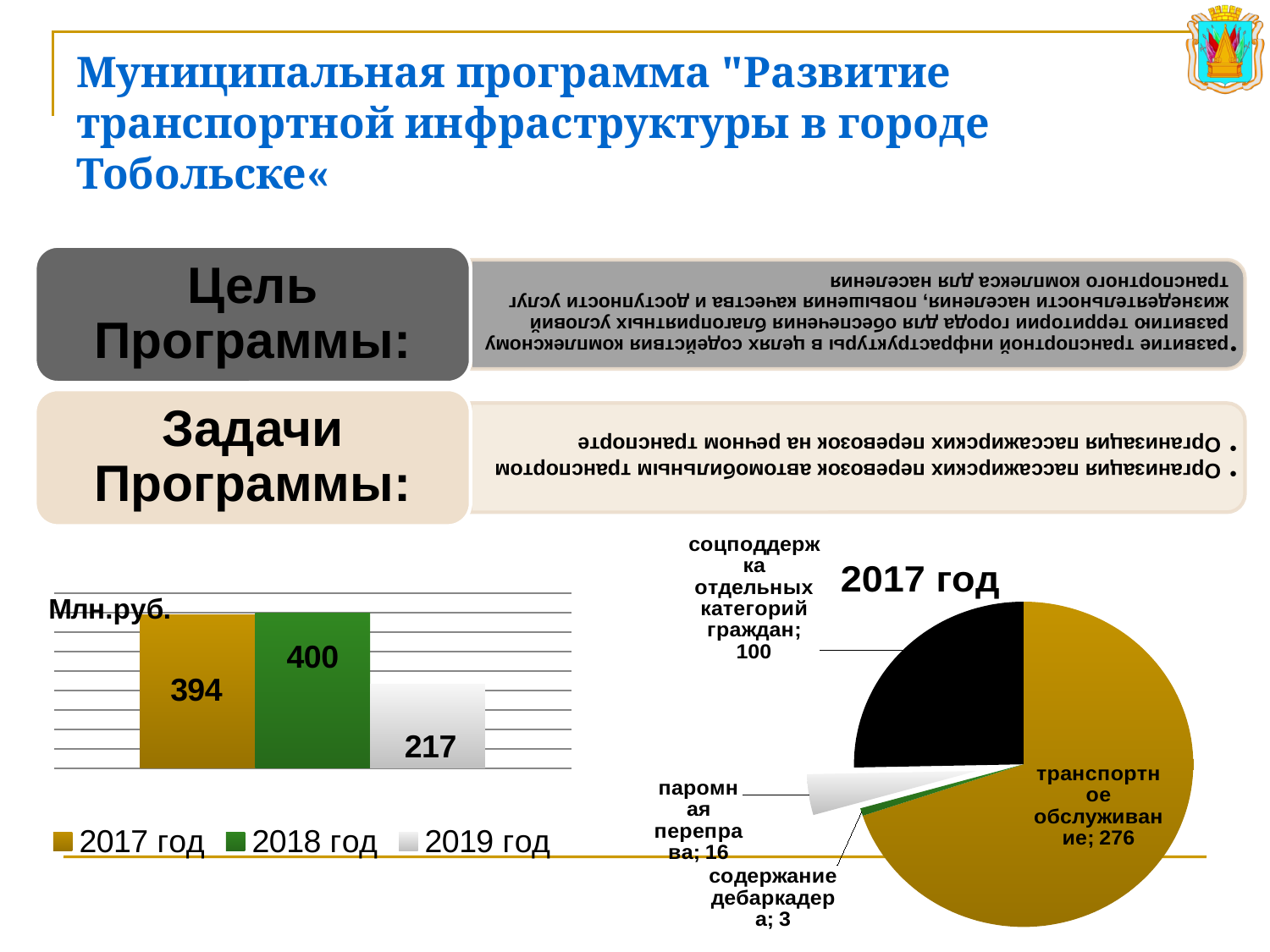
In the pie chart titled 2017 год, what is the value for транспортное обслуживание? 276 In the bar chart on the left (Млн.руб.), which year has the highest value? 2018 год In the bar chart on the left (Млн.руб.), what is the difference between the values for 2018 год and 2019 год? 183 In the pie chart titled 2017 год, how many slices are there? 4 In the bar chart on the left (Млн.руб.), how many series does the legend list? 3 In the bar chart on the left (Млн.руб.), which year has the lowest value? 2019 год In the pie chart titled 2017 год, which is larger: соцподдержка отдельных категорий граждан or паромная переправа? соцподдержка отдельных категорий граждан In the pie chart titled 2017 год, what is the value for паромная переправа? 16 In the bar chart on the left (Млн.руб.), what is the value for 2018 год? 400 What kind of chart is the chart on the left (Млн.руб.)? bar chart In the pie chart titled 2017 год, which category has the smallest slice? содержание дебаркадера In the bar chart on the left (Млн.руб.), what is the value for 2019 год? 217